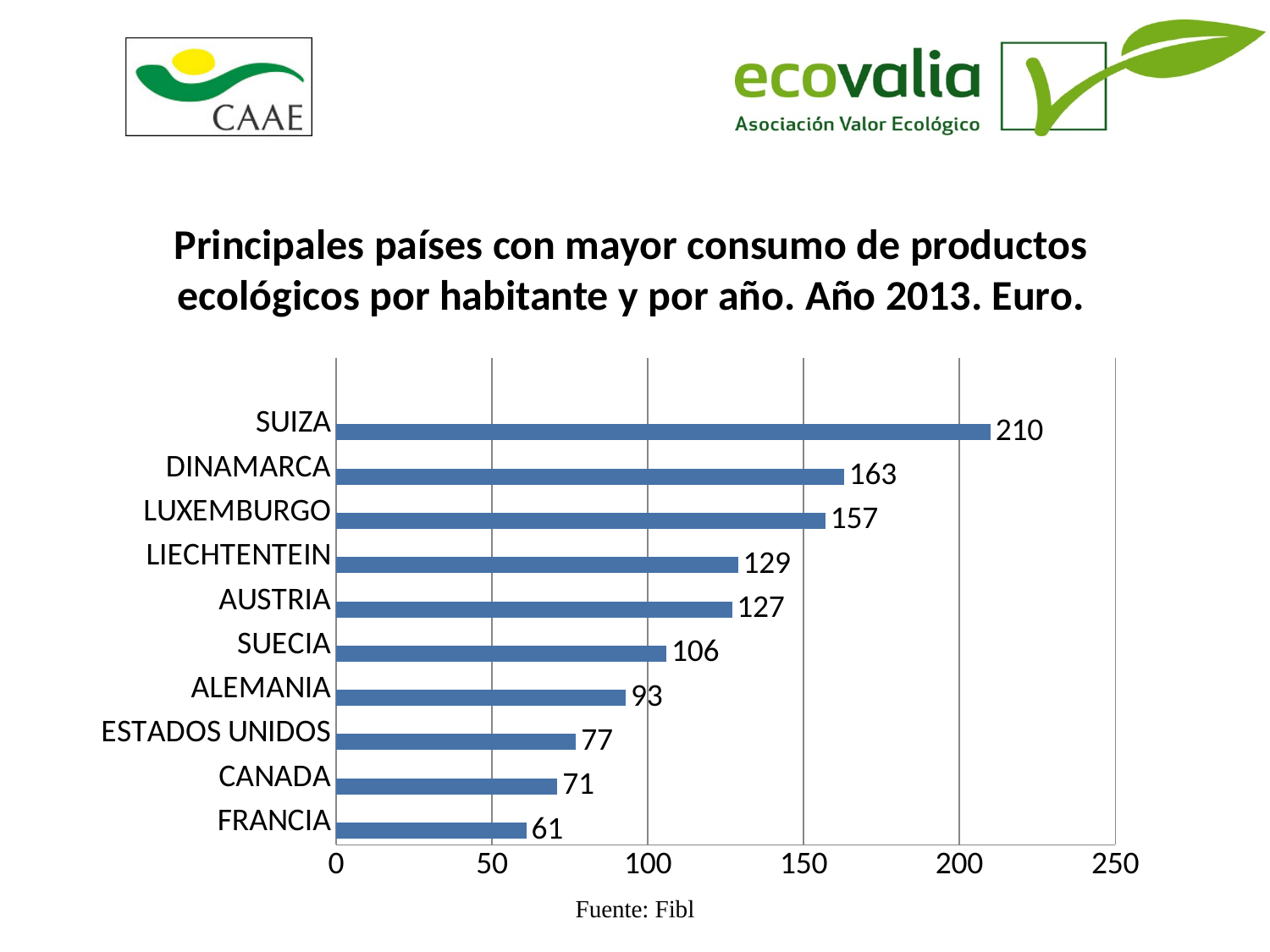
What is the difference between the values for SUIZA and FRANCIA? 149 What source is cited below the chart? Fibl Which country has the lowest value? FRANCIA How many countries are shown in the chart? 10 What kind of chart is shown on the slide? bar chart Is the value for LIECHTENTEIN greater or less than 100? greater What is the value for CANADA? 71 What is the value for SUIZA? 210 Which country has the highest value? SUIZA What is the difference between the values for DINAMARCA and LUXEMBURGO? 6 What is the value for ALEMANIA? 93 Which is larger, the value for SUECIA or the value for ESTADOS UNIDOS? SUECIA